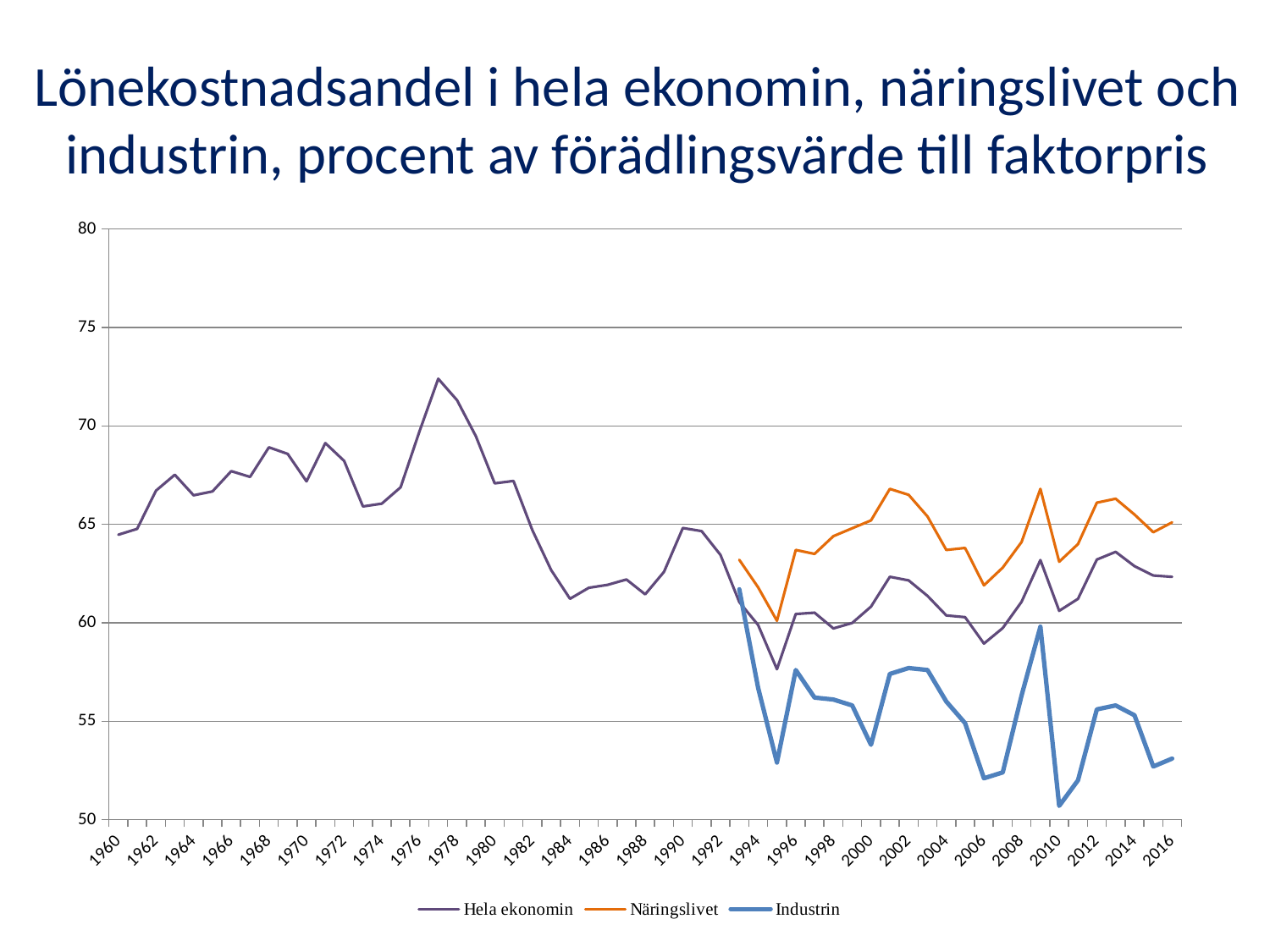
Which series are listed in the legend? Hela ekonomin, Näringslivet, Industrin Is the highest value of Hela ekonomin greater or less than 70? greater Is the value for Industrin in 2010 greater or less than 55? less Which series is drawn in blue? Industrin How many series does the legend list? 3 Is the value for Näringslivet in 2002 greater or less than 65? greater In 2016, which series has the higher value, Näringslivet or Industrin? Näringslivet Which series has the lowest values over the period 1994 to 2016? Industrin What kind of chart is shown on the slide? Line chart Does the value for Hela ekonomin rise or fall between 1978 and 1984? Fall